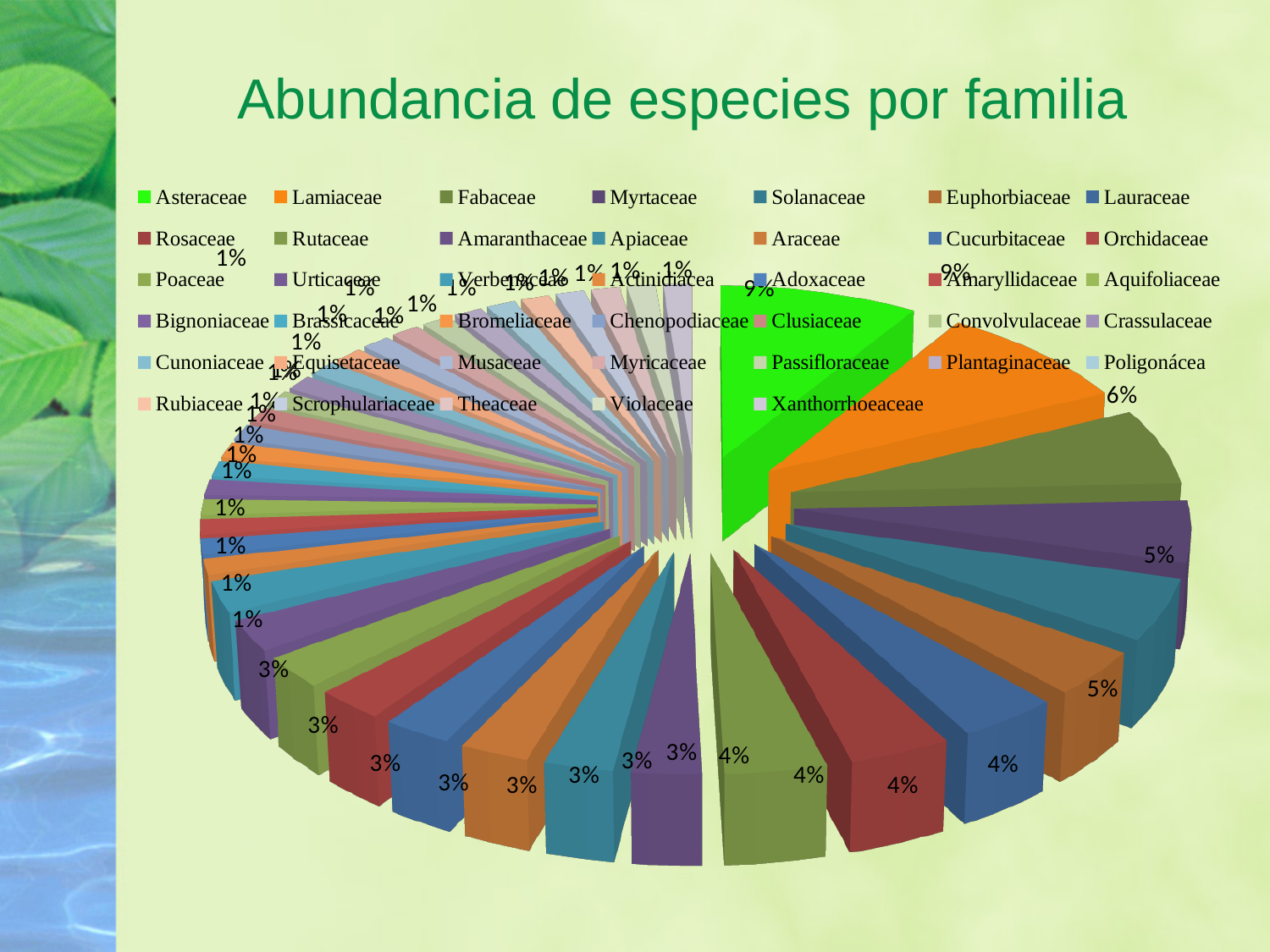
How many families are listed in the legend? 40 What share of the pie does Asteraceae represent? 9% What percentage is shown for Solanaceae? 5% What percentage is shown for Myrtaceae? 5% What percentage is shown for Lamiaceae? 9% What percentage is shown for Fabaceae? 6% What is the title of the chart? Abundancia de especies por familia Which family has the largest slice of the pie? Asteraceae and Lamiaceae (tied at 9%) What colour is the slice for Asteraceae? green Which is larger, the share for Asteraceae or the share for Lamiaceae? Neither; both are 9% What type of chart is shown on the slide? pie chart